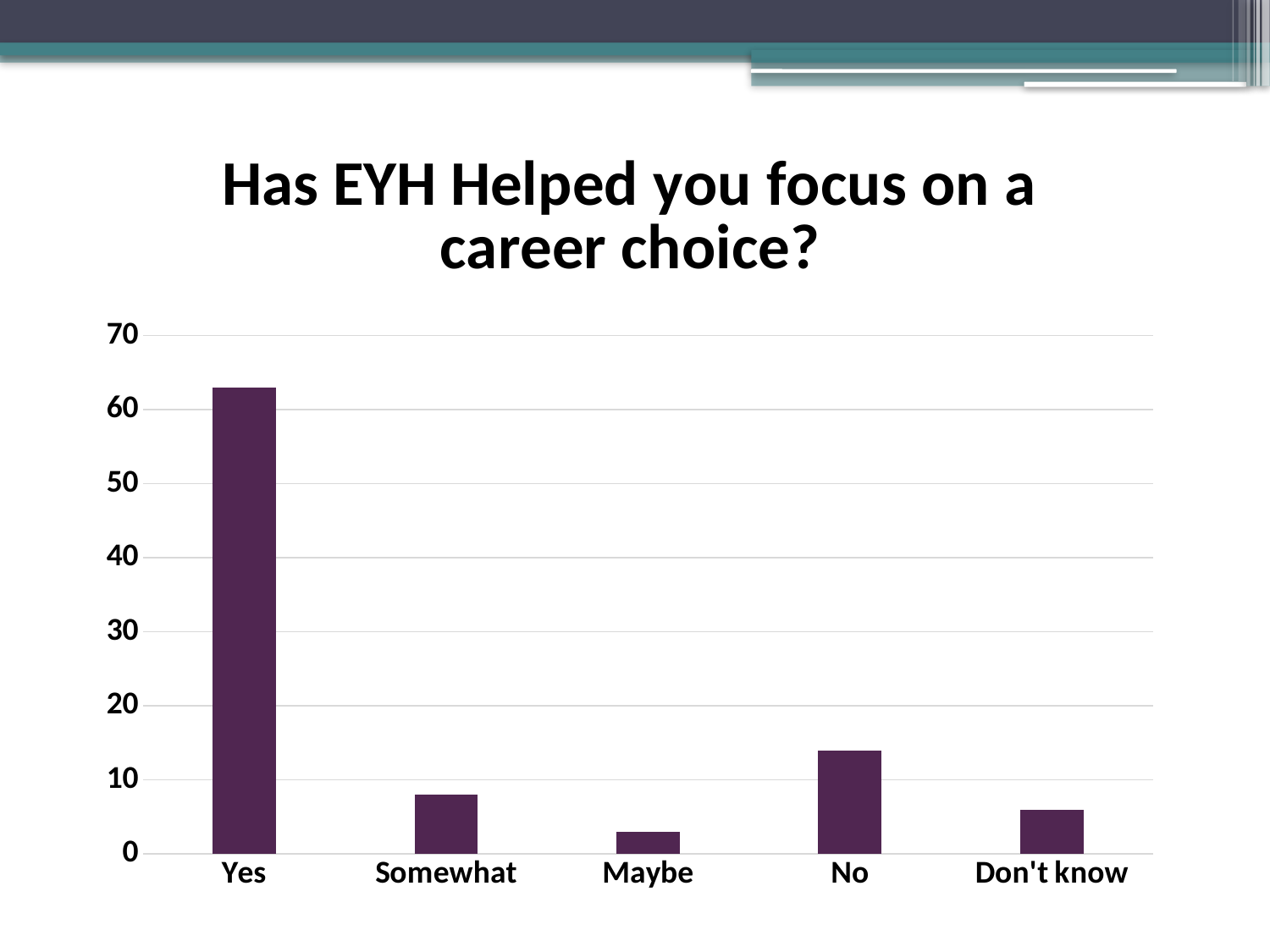
Which category has the highest value? Yes How many categories are shown on the x axis? 5 Which category is second highest after Yes? No Which is larger, the value for No or the value for Somewhat? No Is the value for Don't know greater or less than 10? less Is the value for Somewhat greater or less than 10? less Which is larger, the value for Maybe or the value for Don't know? Don't know Is the value for Yes greater or less than 50? greater What is the title of the chart? Has EYH Helped you focus on a career choice? Which category has the lowest value? Maybe What type of chart is shown on the slide? bar chart